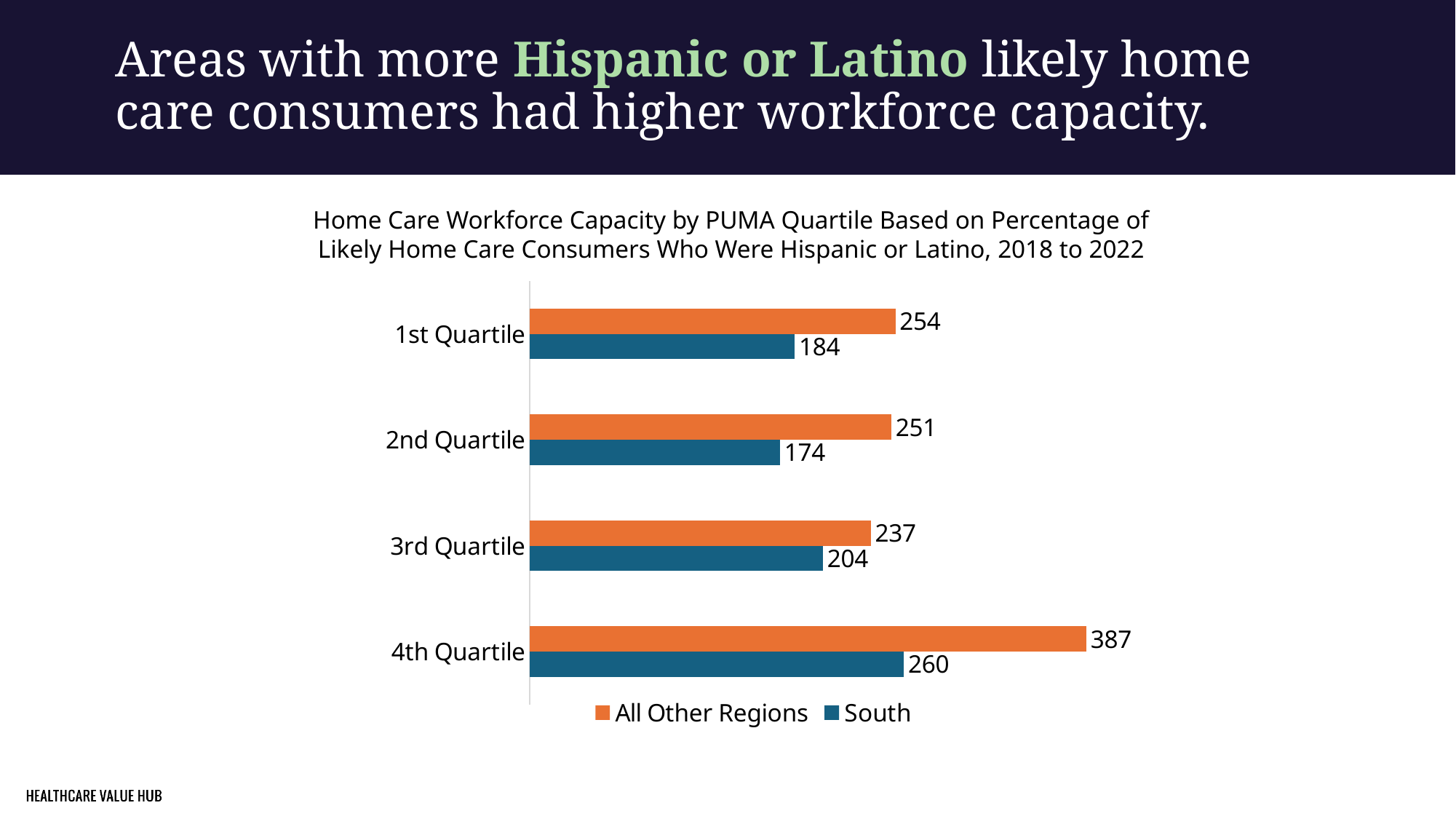
Which quartile has the highest value for All Other Regions? 4th Quartile What is the difference between All Other Regions and South in the 1st Quartile? 70 How many quartile categories are shown on the chart? 4 Which quartile has the lowest value for South? 2nd Quartile How many series does the legend list? 2 What is the difference between All Other Regions and South in the 4th Quartile? 127 What kind of chart is shown on the slide? Bar chart Which is larger in the 3rd Quartile, All Other Regions or South? All Other Regions Which colour represents South in the chart? Blue What is the value for South in the 3rd Quartile? 204 What is the value for South in the 2nd Quartile? 174 What is the value for All Other Regions in the 4th Quartile? 387